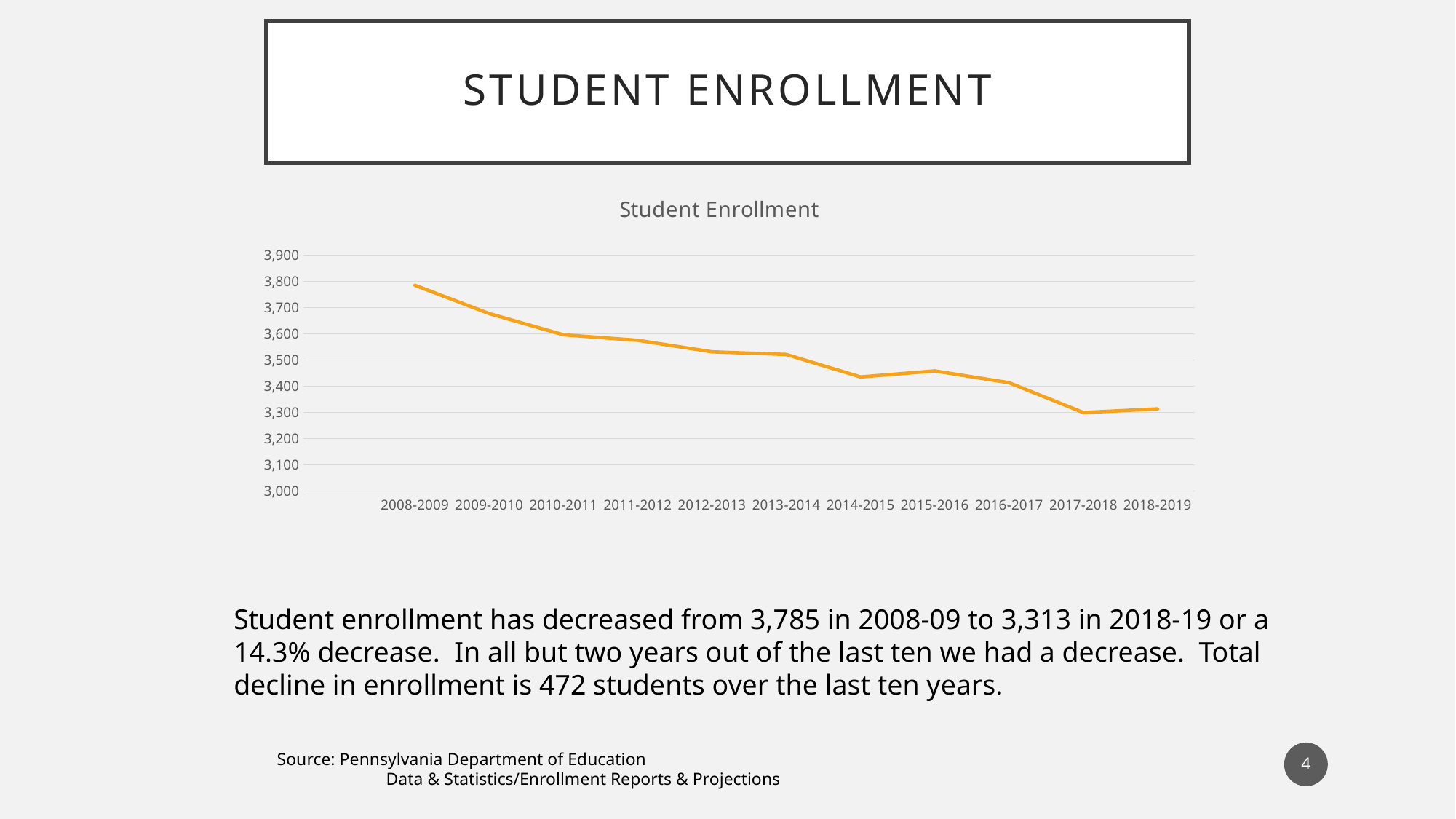
What is the title of the chart? Student Enrollment Which is larger, the enrollment in 2009-2010 or in 2013-2014? 2009-2010 By how much did enrollment decline from 2008-2009 to 2018-2019? 472 Which school year has the highest student enrollment? 2008-2009 What kind of chart is shown on the slide? line chart Is the value for 2012-2013 greater or less than 3,500? greater What was the student enrollment in 2018-2019? 3,313 Do the enrollment values generally rise or fall from 2008-2009 to 2018-2019? fall What was the student enrollment in 2008-2009? 3,785 How many school years are plotted on the x axis of the chart? 11 Is the value for 2017-2018 greater or less than 3,400? less Is the value for 2014-2015 greater or less than 3,500? less